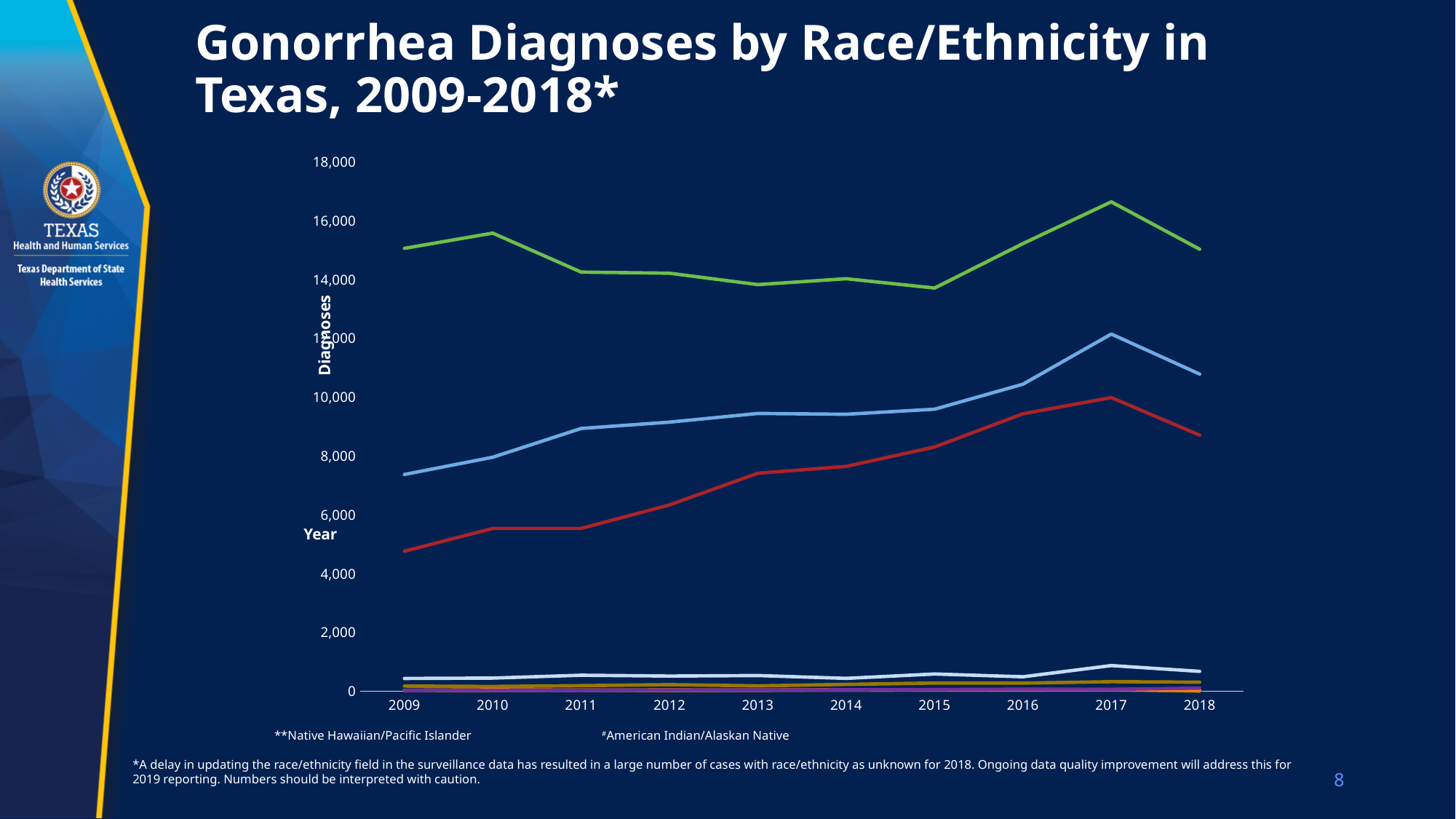
Is the value of the green line in 2017 greater or less than 16,000? greater What kind of chart is shown on the slide? line chart What is the title of the chart on the slide? Gonorrhea Diagnoses by Race/Ethnicity in Texas, 2009-2018* What is the label on the vertical axis of the chart? Diagnoses How many years are plotted along the x axis of the chart? 10 In which year does the red line reach its lowest value? 2009 In 2018, which line has the larger value, the green line or the light blue line? the green line Is the value of the red line in 2009 greater or less than 6,000? less Is the value of the light blue line in 2017 greater or less than 10,000? greater Does the red line generally rise or fall from 2009 to 2017? rise In which year does the light blue line reach its highest value? 2017 In which year does the green line reach its highest value? 2017